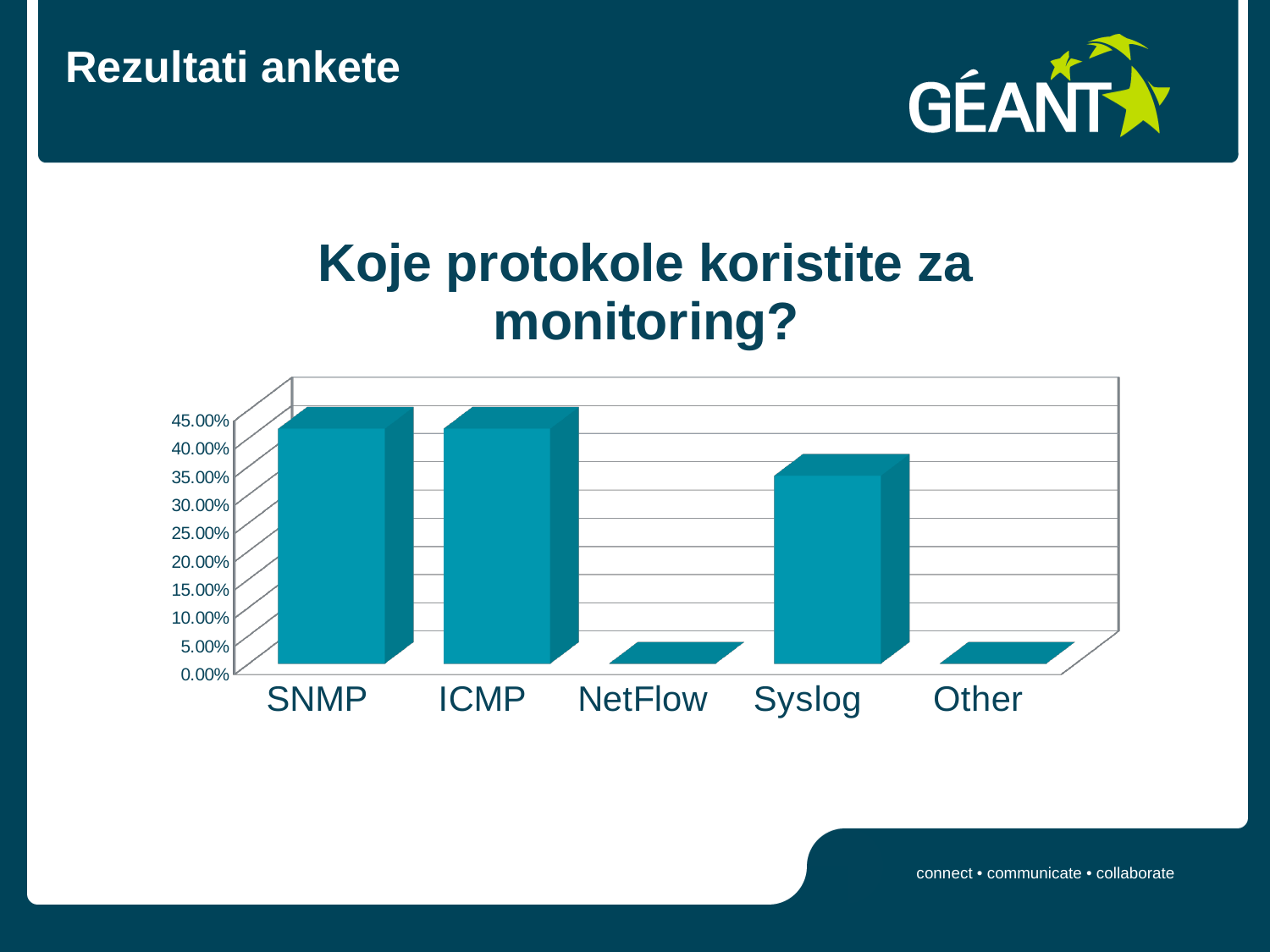
Is the value for Syslog greater or less than 30.00%? greater Is the value for Other greater or less than 5.00%? less What is the title of the chart? Koje protokole koristite za monitoring? Is the value for NetFlow greater or less than 5.00%? less How many protocol categories are shown on the x axis of the chart? 5 What type of chart is shown on the slide? bar chart Which has a larger value, ICMP or Other? ICMP Which has a larger value, Syslog or NetFlow? Syslog Which has a larger value, SNMP or Syslog? SNMP